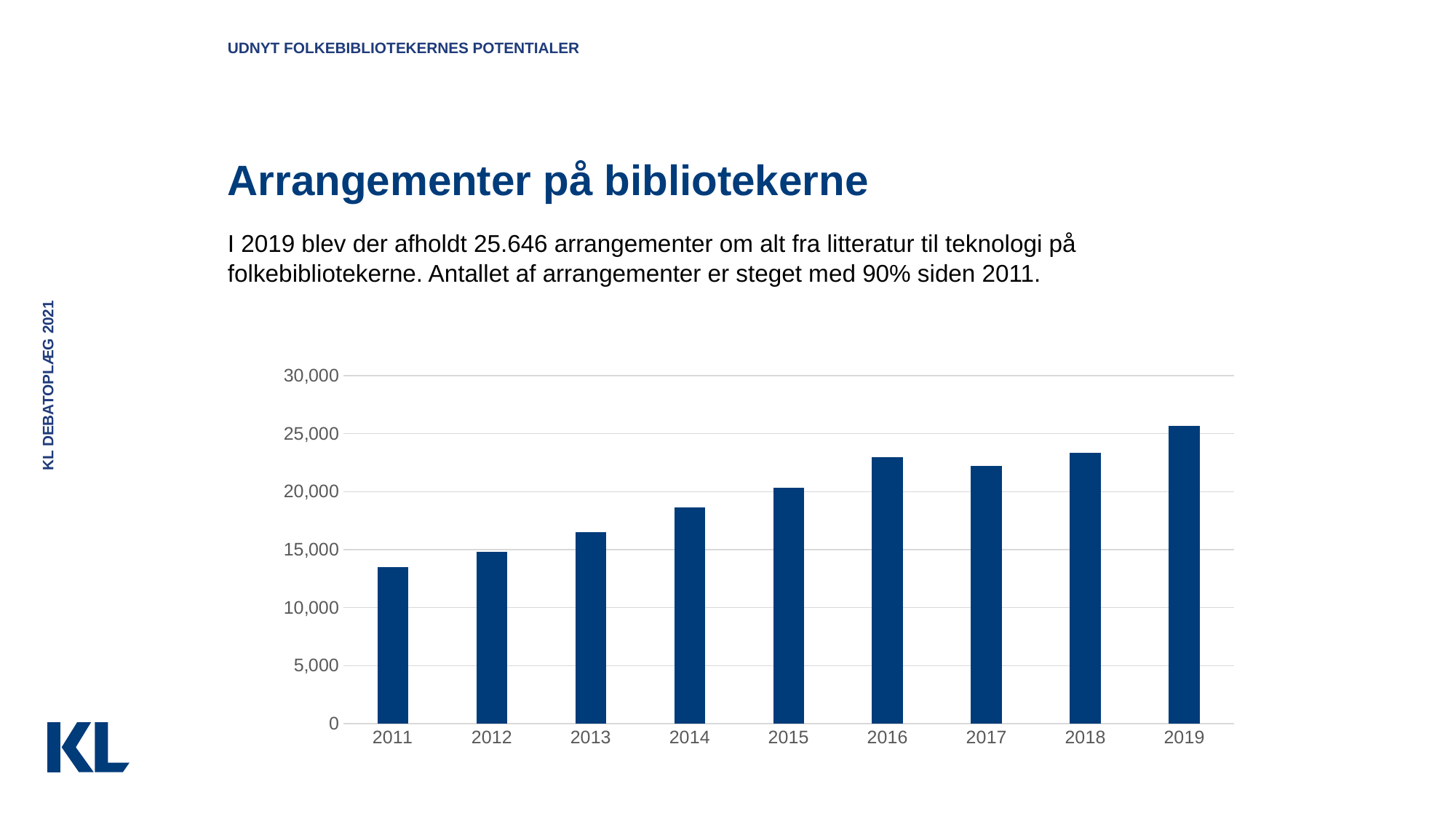
Is the value for 2014 greater or less than 20,000? less Do the values generally rise or fall from 2011 to 2019? rise How many years are shown on the x axis of the chart? 9 Is the value for 2011 greater or less than 15,000? less What is the title of the slide containing the chart? Arrangementer på bibliotekerne Is the value for 2013 greater or less than 15,000? greater What kind of chart is shown on the slide? bar chart Which year has the lowest bar in the chart? 2011 Which year has the highest bar in the chart? 2019 Which year has the higher bar, 2016 or 2017? 2016